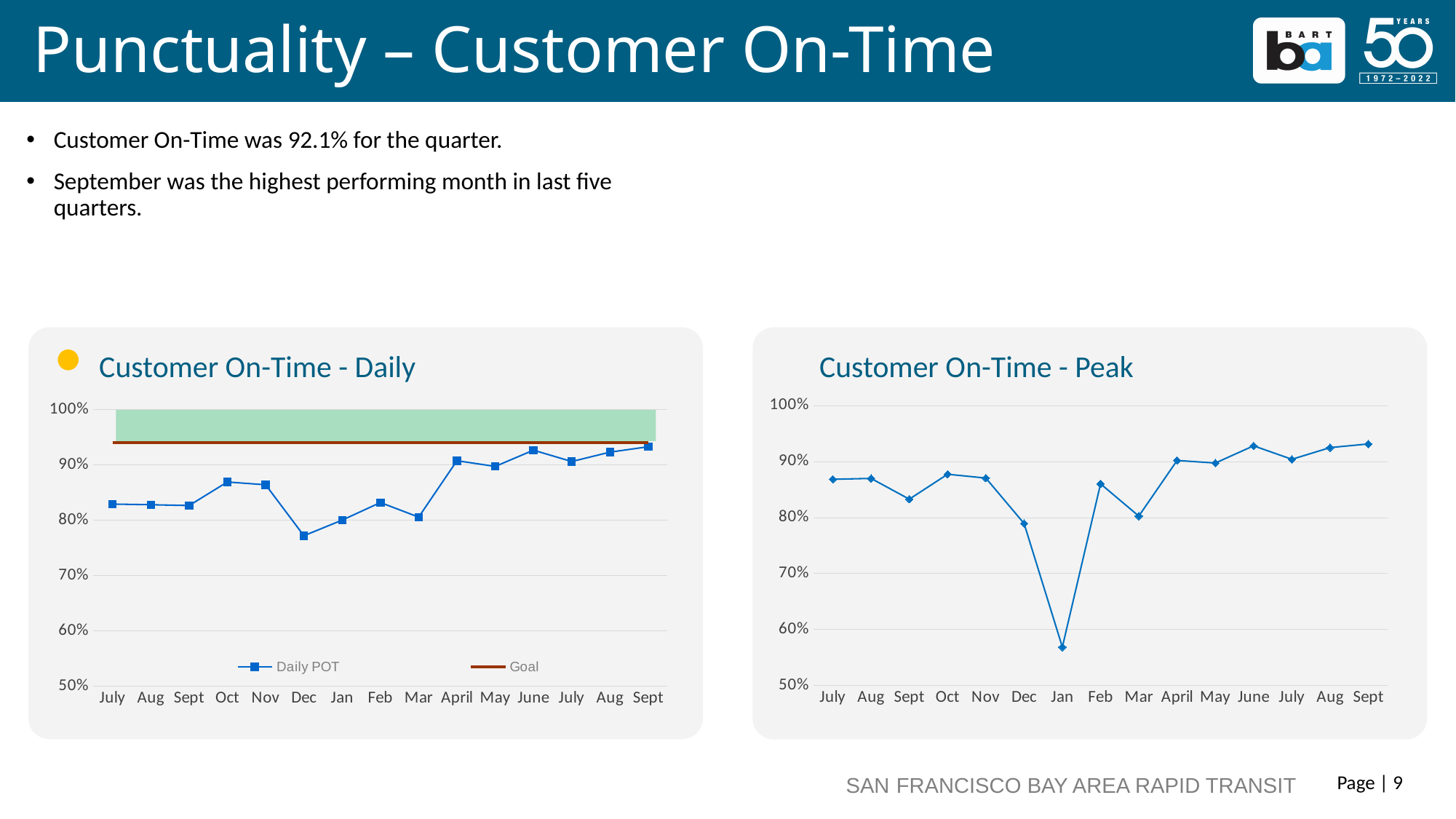
What kind of chart is the Customer On-Time - Peak chart? line chart In the Customer On-Time - Peak chart, is the value for Jan greater or less than 60%? less In the Customer On-Time - Peak chart, do the values rise or fall from Jan to April? rise What are the two legend entries in the Customer On-Time - Daily chart? Daily POT and Goal How many series does the legend of the Customer On-Time - Daily chart list? 2 In the Customer On-Time - Daily chart, is the Daily POT value for Dec greater or less than 80%? less In the Customer On-Time - Peak chart, is the value for the final Sept greater or less than 90%? greater In the Customer On-Time - Peak chart, which month has the lowest value? Jan How many months are plotted on the x axis of the Customer On-Time - Peak chart? 15 In the Customer On-Time - Daily chart, which month has the lowest Daily POT value? Dec What kind of chart is the Customer On-Time - Daily chart? line chart In the Customer On-Time - Daily chart, which is higher, the Daily POT value for Oct or for Dec? Oct